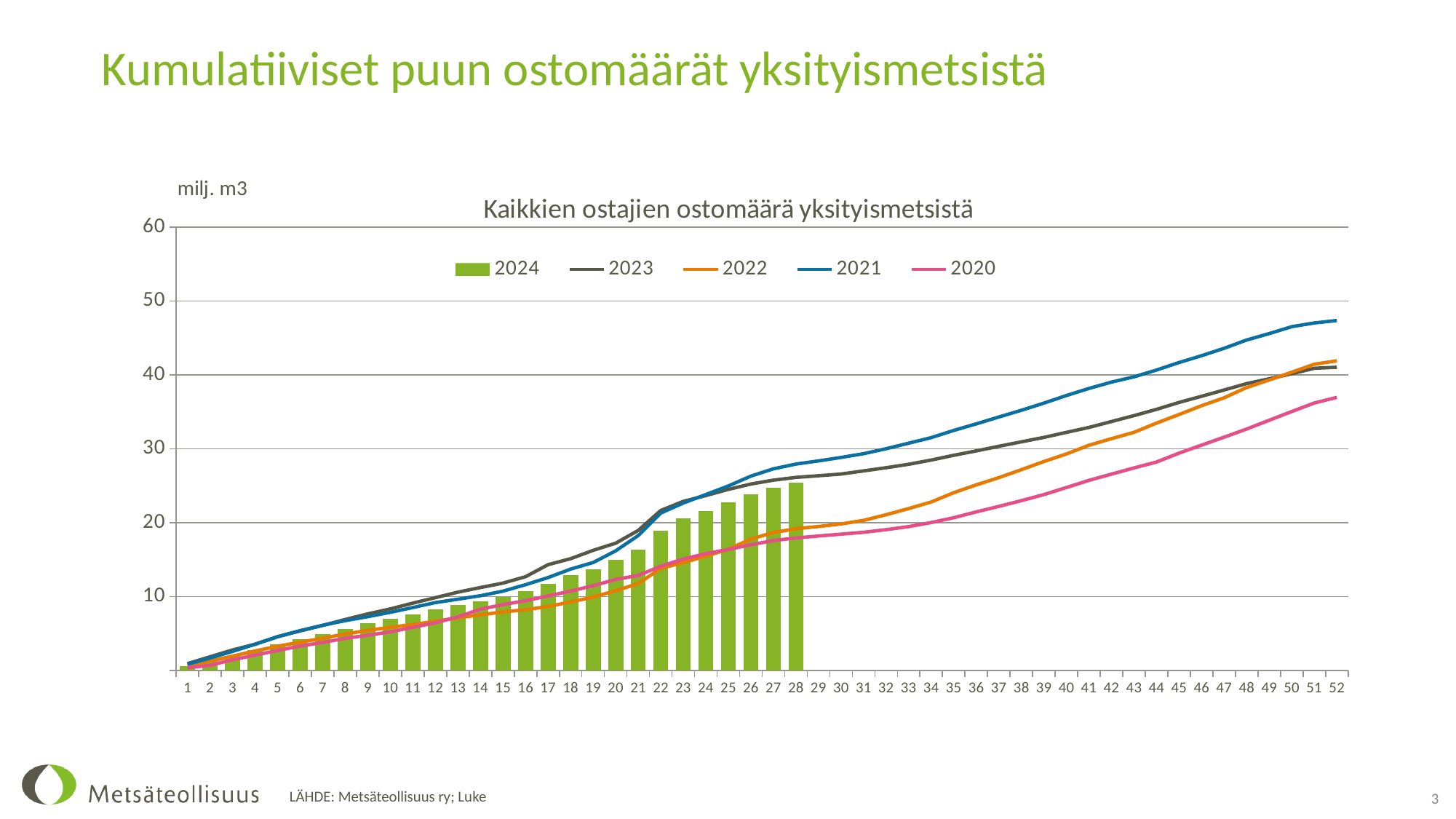
At point 28, which is larger: the 2021 line or the 2020 line? 2021 What kind of chart is this? Combined bar and line chart Do the values of the 2021 line rise or fall along the x axis? Rise Which series has the highest value at point 52? 2021 How many points are on the x axis? 52 Is the value of the 2020 line at point 52 greater or less than 40? less What is the chart's title? Kaikkien ostajien ostomäärä yksityismetsistä How many series does the legend list? 5 Which series is drawn as bars rather than a line? 2024 Is the value of the 2021 line at point 52 greater or less than 40? greater Which series has the lowest value at point 52? 2020 How many bars are plotted for the 2024 series? 28